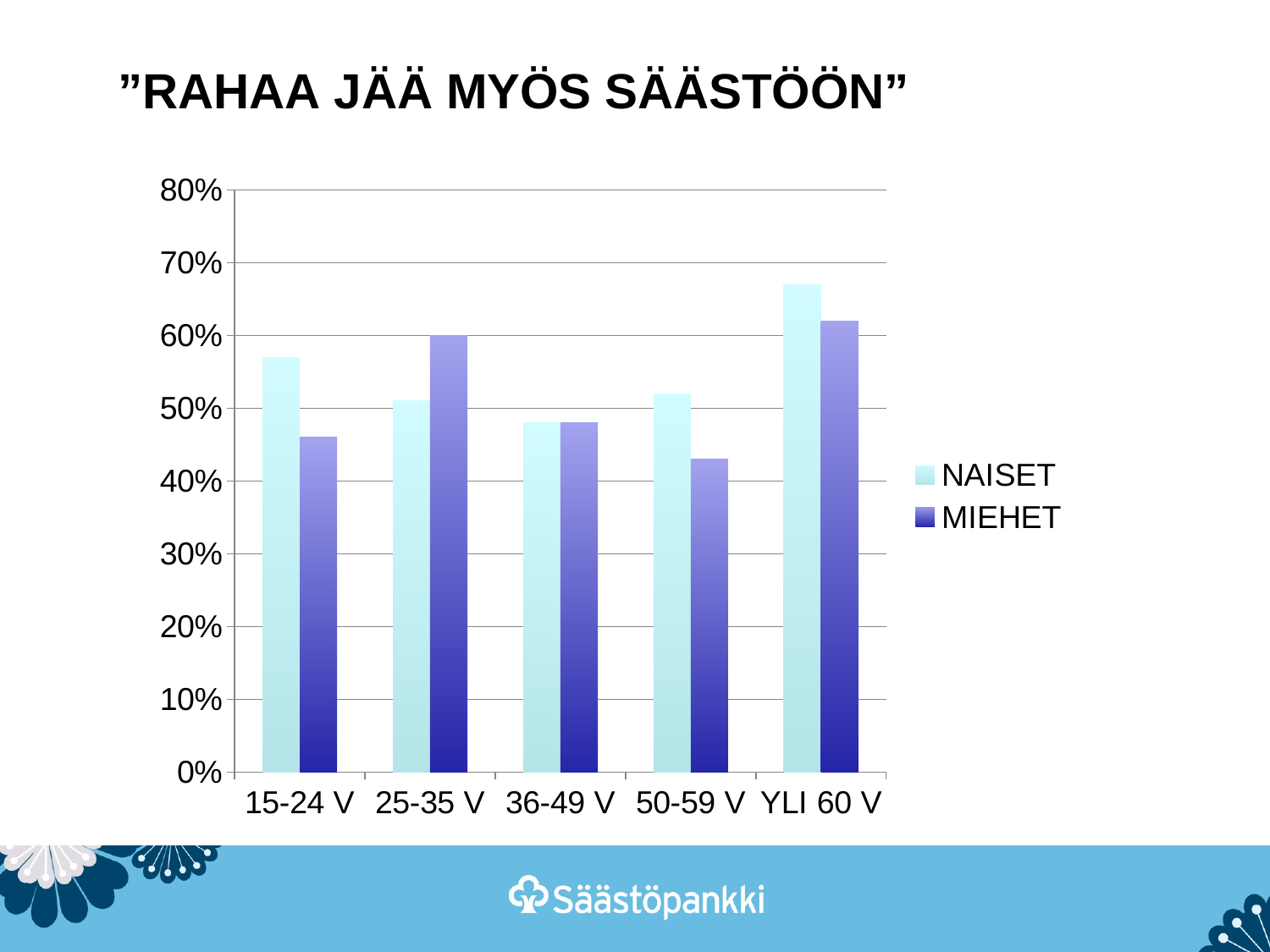
For the 25-35 V group, which is larger, NAISET or MIEHET? MIEHET How many age groups are shown on the x axis? 5 What is the title of the slide? "RAHAA JÄÄ MYÖS SÄÄSTÖÖN" What are the two series named in the legend? NAISET and MIEHET How many series does the legend list? 2 Is the NAISET value for 15-24 V greater or less than 50%? greater Is the NAISET value for YLI 60 V greater or less than 60%? greater For the 15-24 V group, which is larger, NAISET or MIEHET? NAISET Which age group has the lowest MIEHET value? 50-59 V Which age group has the highest NAISET value? YLI 60 V What kind of chart is shown on the slide? bar chart Is the MIEHET value for 50-59 V greater or less than 50%? less